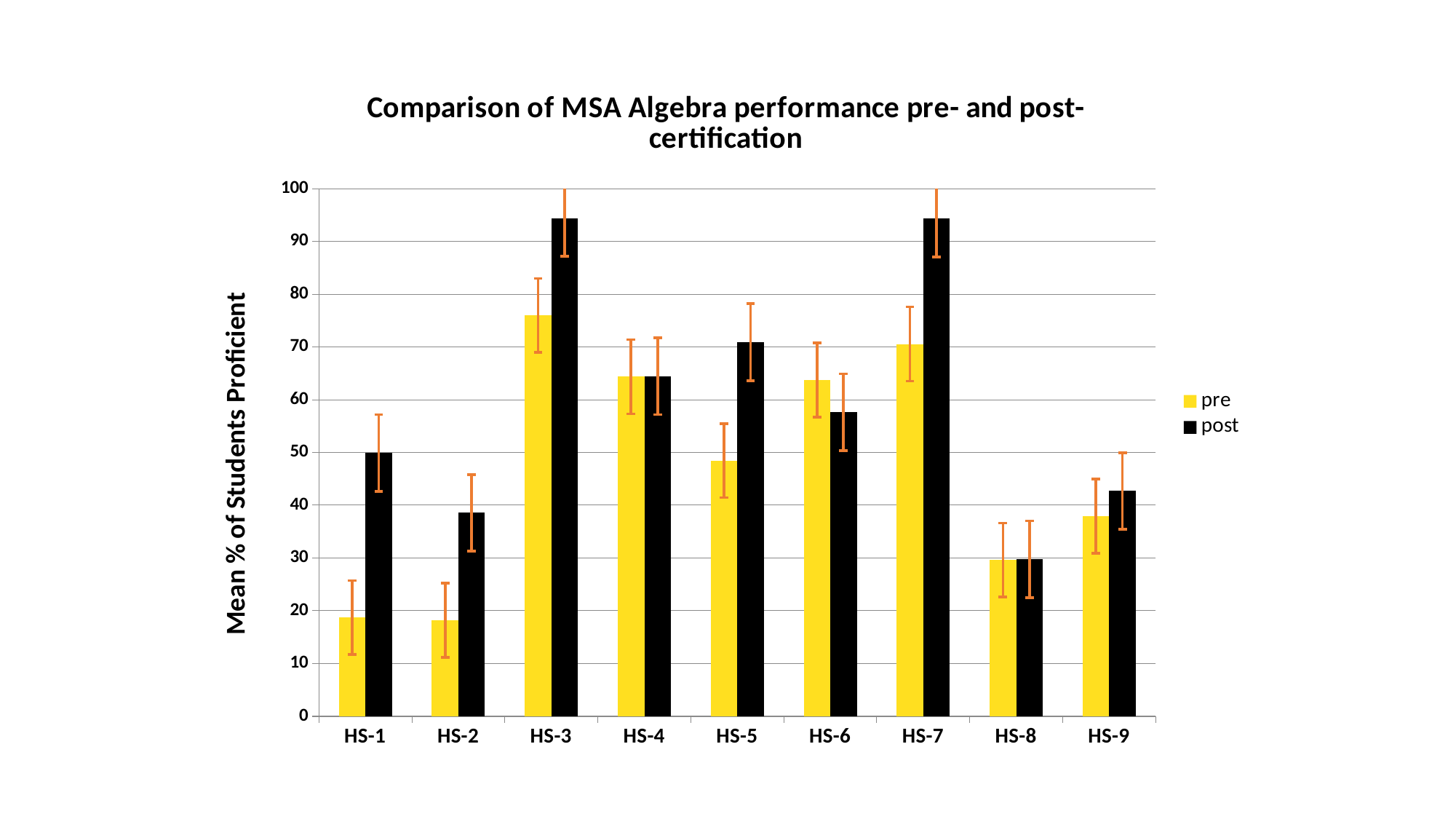
Is the pre value for HS-8 greater or less than 40? less For HS-6, which is larger, the pre value or the post value? pre How many series does the legend list? 2 Is the post value for HS-3 greater or less than 90? greater Is the post value for HS-1 greater or less than 40? greater What is the label of the y axis? Mean % of Students Proficient Which high school has the lowest post value? HS-8 What type of chart is shown on the slide? bar chart For HS-5, which is larger, the pre value or the post value? post Which high school has the highest pre value? HS-3 What is the title of the chart? Comparison of MSA Algebra performance pre- and post-certification How many high schools (categories) are shown on the x axis? 9